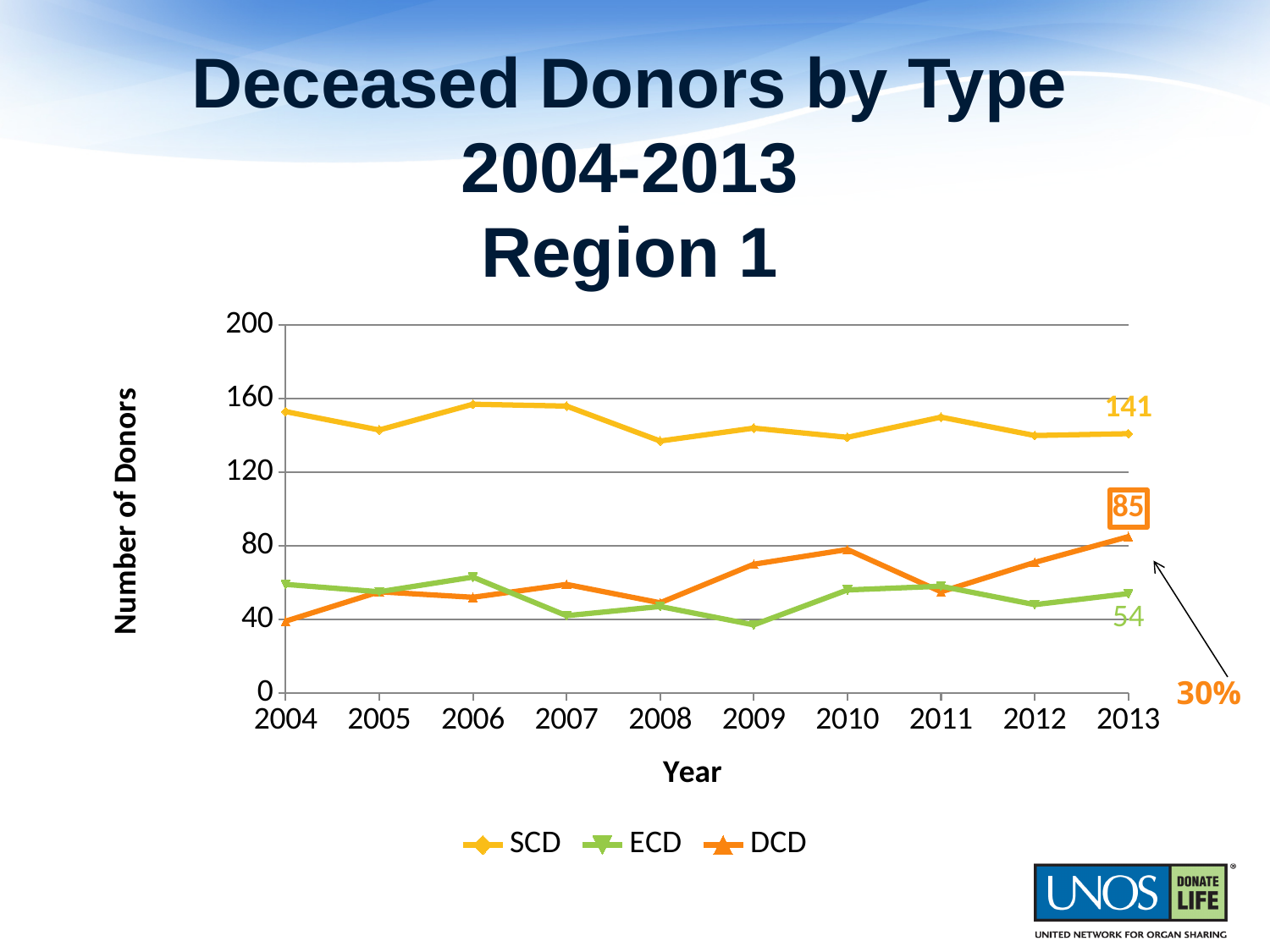
Is the value for SCD in 2004 greater or less than 140? greater What is the difference between the DCD and ECD values in 2013? 31 What is the value for SCD in 2013? 141 How many years are shown on the x axis? 10 Which series has the highest value in 2013? SCD In 2013, which is larger, DCD or ECD? DCD How many series does the legend list? 3 What kind of chart is shown on the slide? line chart Is the value for DCD in 2004 greater or less than 80? less What is the value for DCD in 2013? 85 What is the difference between the SCD and DCD values in 2013? 56 What is the value for ECD in 2013? 54